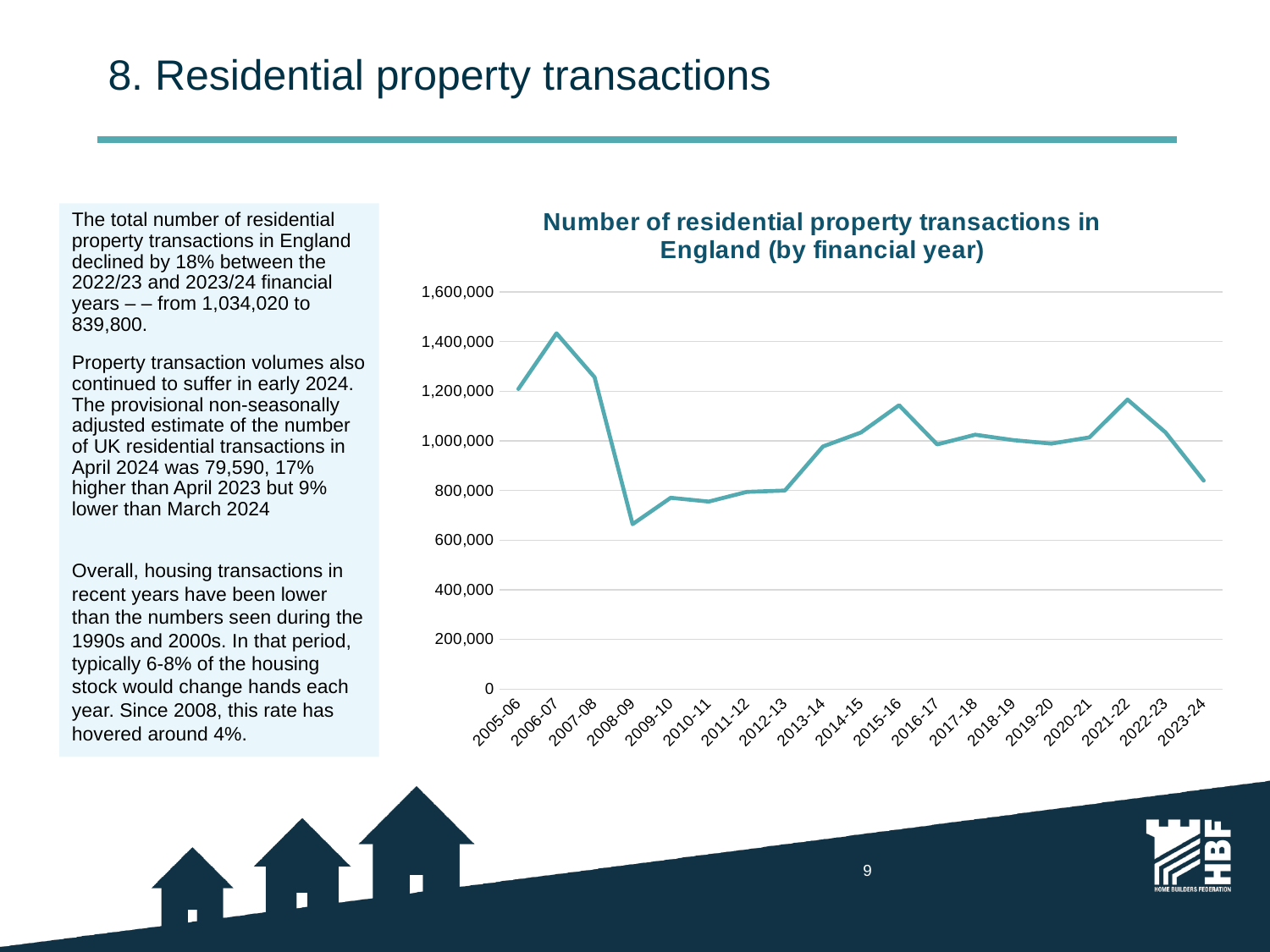
Which financial year has the highest number of residential property transactions in the chart? 2006-07 Is the value for 2006-07 greater or less than 1,200,000? greater Do the values rise or fall between 2006-07 and 2008-09? fall What kind of chart is shown on the slide? line chart Is the value for 2023-24 greater or less than 1,000,000? less What is the title of the chart? Number of residential property transactions in England (by financial year) Which financial year has the lowest number of residential property transactions in the chart? 2008-09 Is the value for 2015-16 greater or less than 1,000,000? greater Which is larger, the value for 2021-22 or the value for 2023-24? 2021-22 Which is larger, the value for 2015-16 or the value for 2016-17? 2015-16 How many financial years are plotted on the x axis of the chart? 19